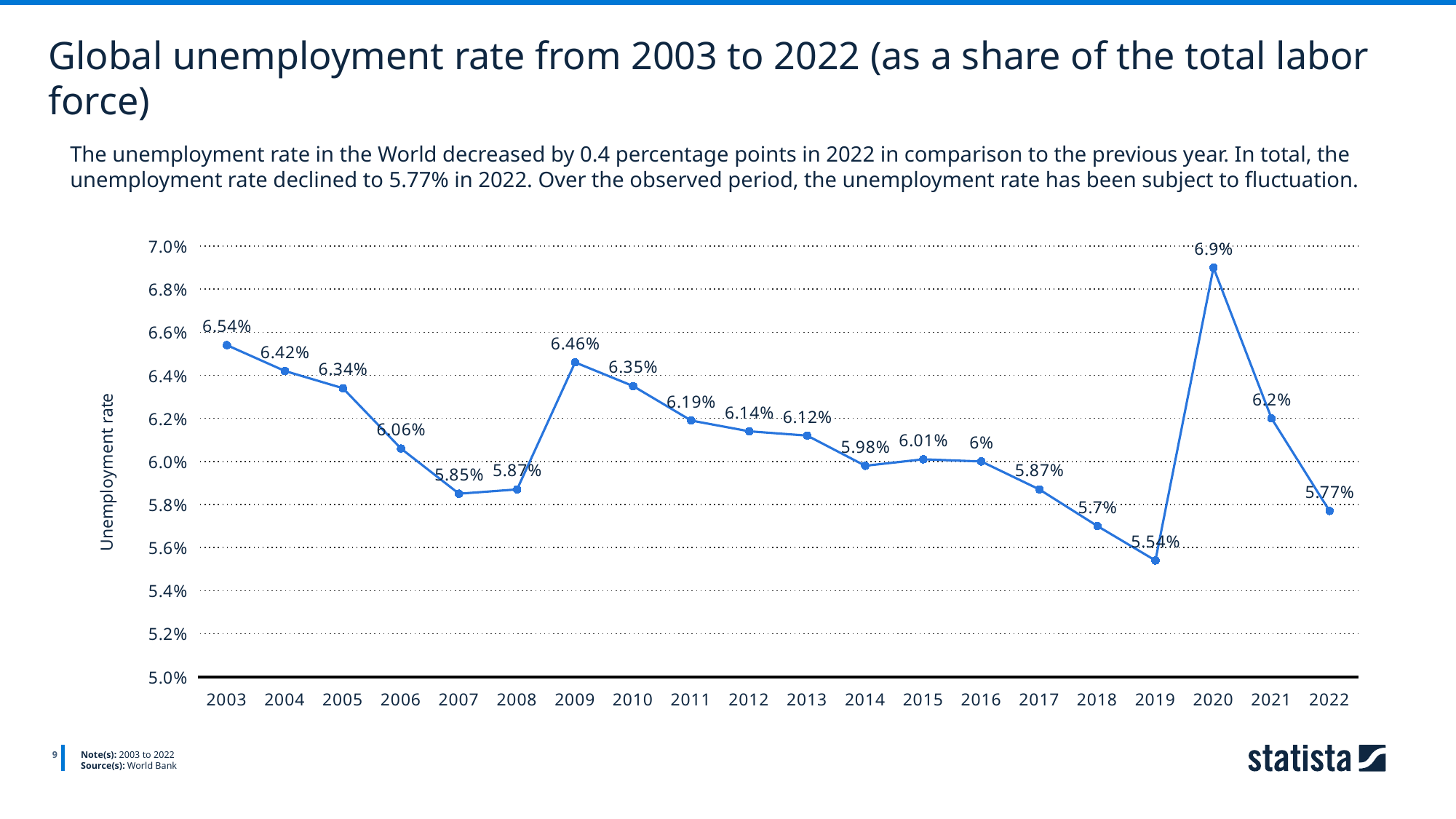
What was the global unemployment rate in 2020? 6.9% What is the label of the vertical axis? Unemployment rate Did the global unemployment rate rise or fall from 2020 to 2022? Fall Which year had the highest global unemployment rate? 2020 What was the global unemployment rate in 2003? 6.54% Which year had a higher unemployment rate, 2009 or 2010? 2009 Is the unemployment rate for 2018 greater or less than 5.8%? less Which year had the lowest global unemployment rate? 2019 By how many percentage points did the global unemployment rate change from 2019 to 2020? 1.36 percentage points How many years are plotted on the chart? 20 What type of chart is shown on the slide? Line chart What was the global unemployment rate in 2022? 5.77%